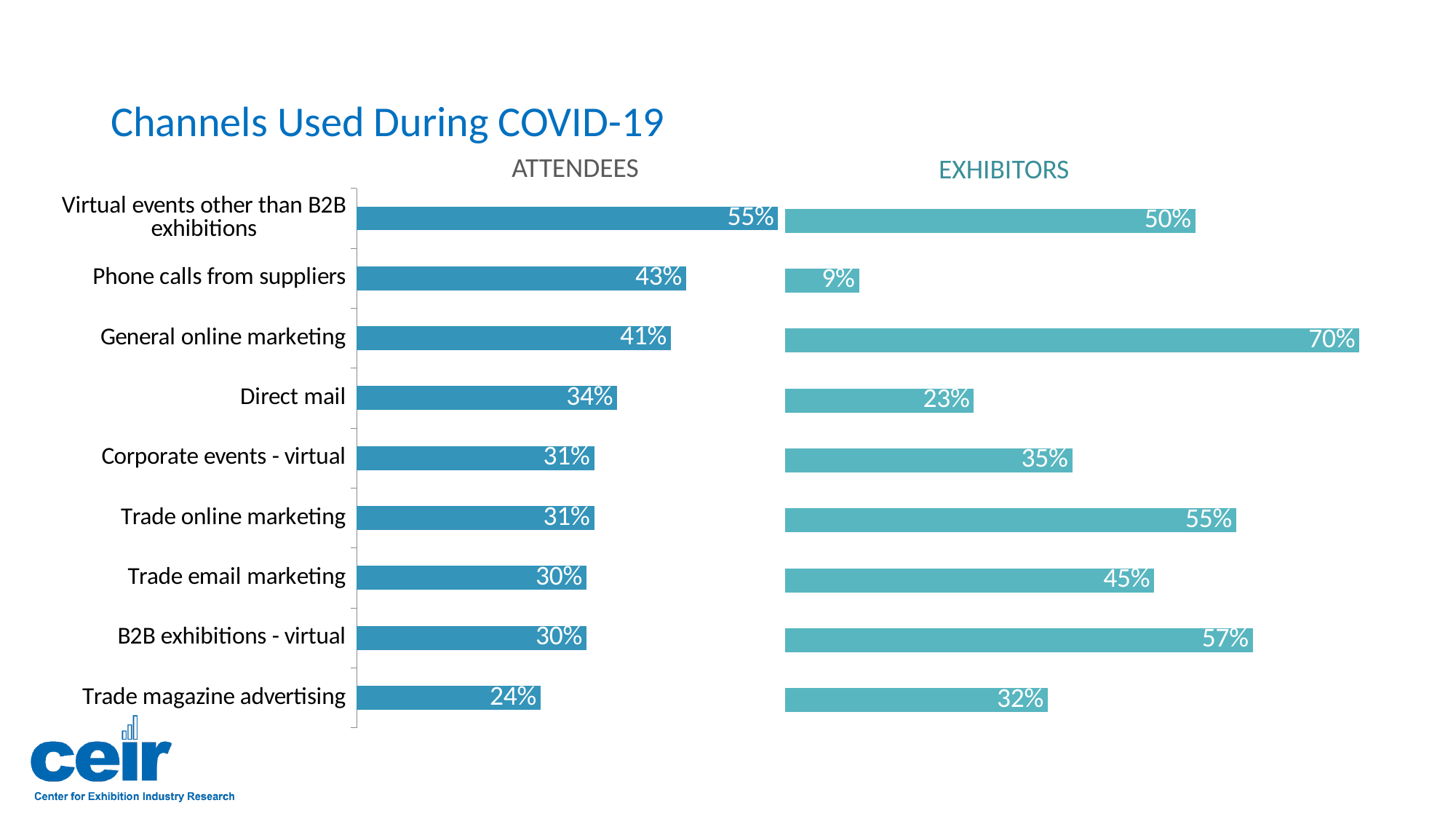
In the Attendees chart, what percentage is shown for Phone calls from suppliers? 43% How many channels are listed in the Attendees chart? 9 What type of chart is used for the Exhibitors data? Bar chart In the Attendees chart, which channel has the highest percentage? Virtual events other than B2B exhibitions In the Attendees chart, which channel has the lowest percentage? Trade magazine advertising For Direct mail, which chart shows the larger value, Attendees or Exhibitors? Attendees In the Exhibitors chart, which channel has the lowest percentage? Phone calls from suppliers What is the title of the slide containing the two charts? Channels Used During COVID-19 In the Exhibitors chart, what percentage is shown for Phone calls from suppliers? 9% What is the difference between the Exhibitors and Attendees percentages for General online marketing? 29% For B2B exhibitions - virtual, which chart shows the larger value, Attendees or Exhibitors? Exhibitors In the Exhibitors chart, what percentage is shown for General online marketing? 70%